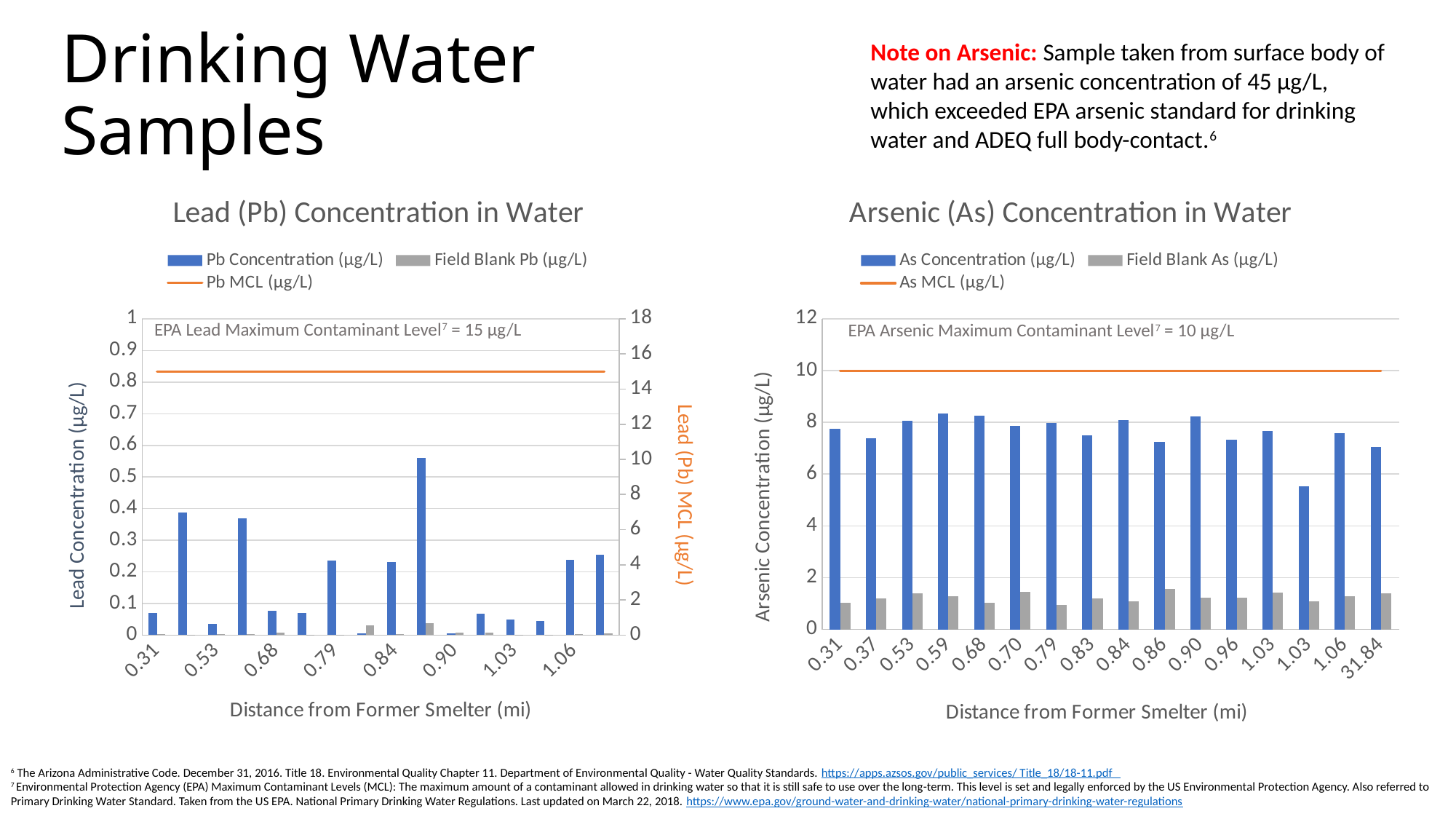
In the "Lead (Pb) Concentration in Water" chart, which has the larger Pb Concentration: 0.53 mi or 0.31 mi? 0.31 In the "Lead (Pb) Concentration in Water" chart, is the Pb Concentration at 0.53 mi greater or less than 0.3? less In the "Arsenic (As) Concentration in Water" chart, at which distance is the As Concentration lowest? 1.03 What is the x-axis title of the "Arsenic (As) Concentration in Water" chart? Distance from Former Smelter (mi) What kind of chart is the "Lead (Pb) Concentration in Water" chart? combination bar and line chart In the "Arsenic (As) Concentration in Water" chart, which has the larger As Concentration: 0.59 mi or 0.37 mi? 0.59 In the "Arsenic (As) Concentration in Water" chart, is the As Concentration at 0.31 mi greater or less than 6? greater In the "Lead (Pb) Concentration in Water" chart, what is the EPA Lead Maximum Contaminant Level shown? 15 µg/L How many series does the legend of the "Arsenic (As) Concentration in Water" chart list? 3 How many distance categories are shown on the x axis of the "Arsenic (As) Concentration in Water" chart? 16 In the "Arsenic (As) Concentration in Water" chart, what is the EPA Arsenic Maximum Contaminant Level shown? 10 µg/L How many series does the legend of the "Lead (Pb) Concentration in Water" chart list? 3